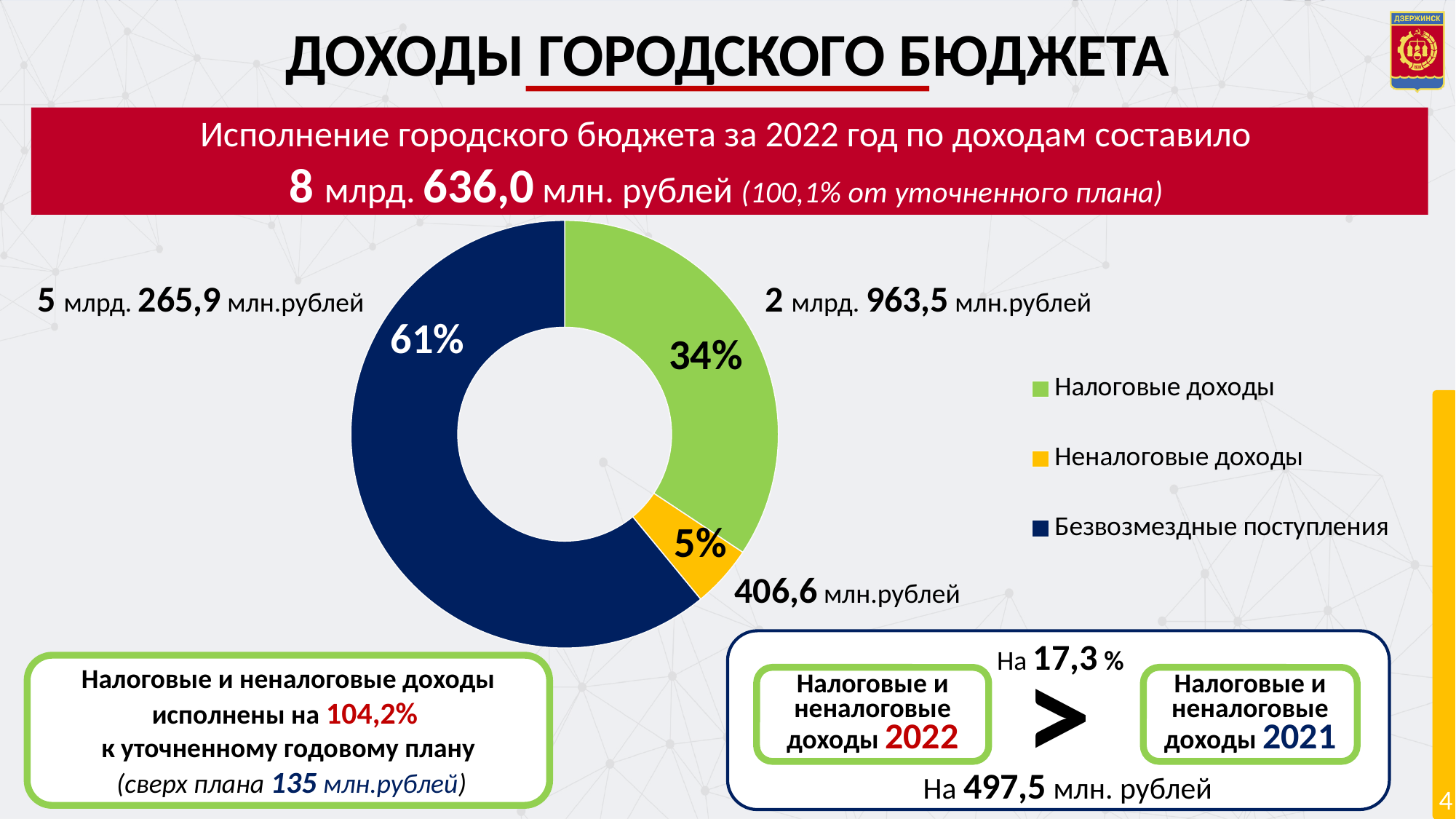
What share of the donut chart does Неналоговые доходы represent? 5% Which category has the smallest share of the donut chart? Неналоговые доходы What is the amount shown for Неналоговые доходы? 406,6 млн.рублей What type of chart is shown on the slide? Donut (pie) chart What is the amount shown for Безвозмездные поступления? 5 млрд. 265,9 млн.рублей How many categories does the donut chart show? 3 Which category has the largest share of the donut chart? Безвозмездные поступления What is the amount shown for Налоговые доходы? 2 млрд. 963,5 млн.рублей Which is larger: the share of Налоговые доходы or the share of Неналоговые доходы? Налоговые доходы What share of the donut chart does Безвозмездные поступления represent? 61% By how many percentage points does the share of Безвозмездные поступления exceed the share of Налоговые доходы? 27% What share of the donut chart does Налоговые доходы represent? 34%